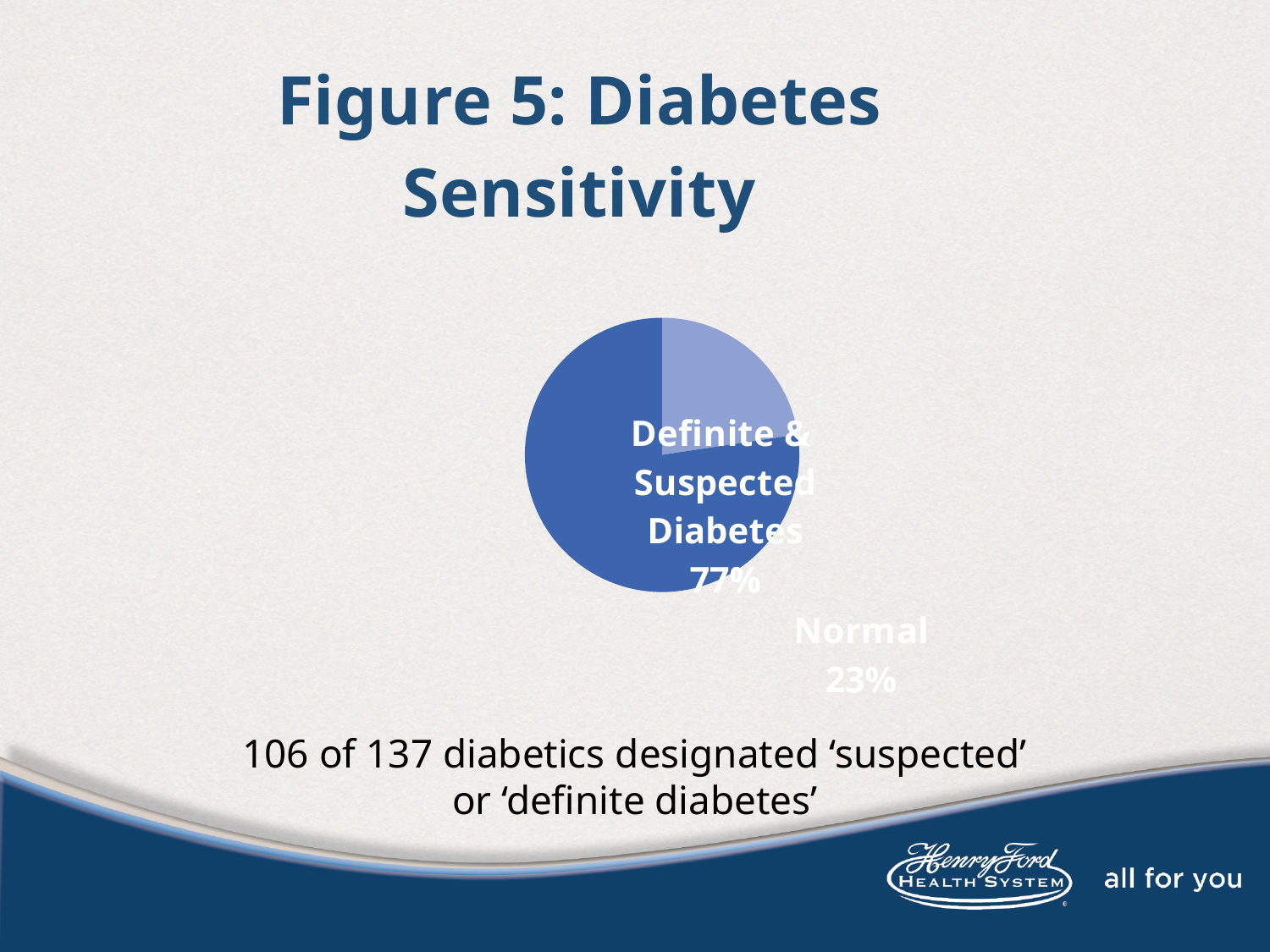
Which slice of the pie is shown in the lighter blue colour? Normal How many slices does the pie chart have? 2 What is the title of the slide containing the pie chart? Figure 5: Diabetes Sensitivity What share of the pie is labelled 'Normal'? 23% Is the share for 'Normal' greater or less than 50%? less What is the difference in percentage points between the 'Definite & Suspected Diabetes' slice and the 'Normal' slice? 54 Which is larger, the 'Normal' slice or the 'Definite & Suspected Diabetes' slice? Definite & Suspected Diabetes What kind of chart is shown on the slide? pie chart What share of the pie is labelled 'Definite & Suspected Diabetes'? 77% Which slice of the pie is the largest? Definite & Suspected Diabetes Which slice of the pie is the smallest? Normal